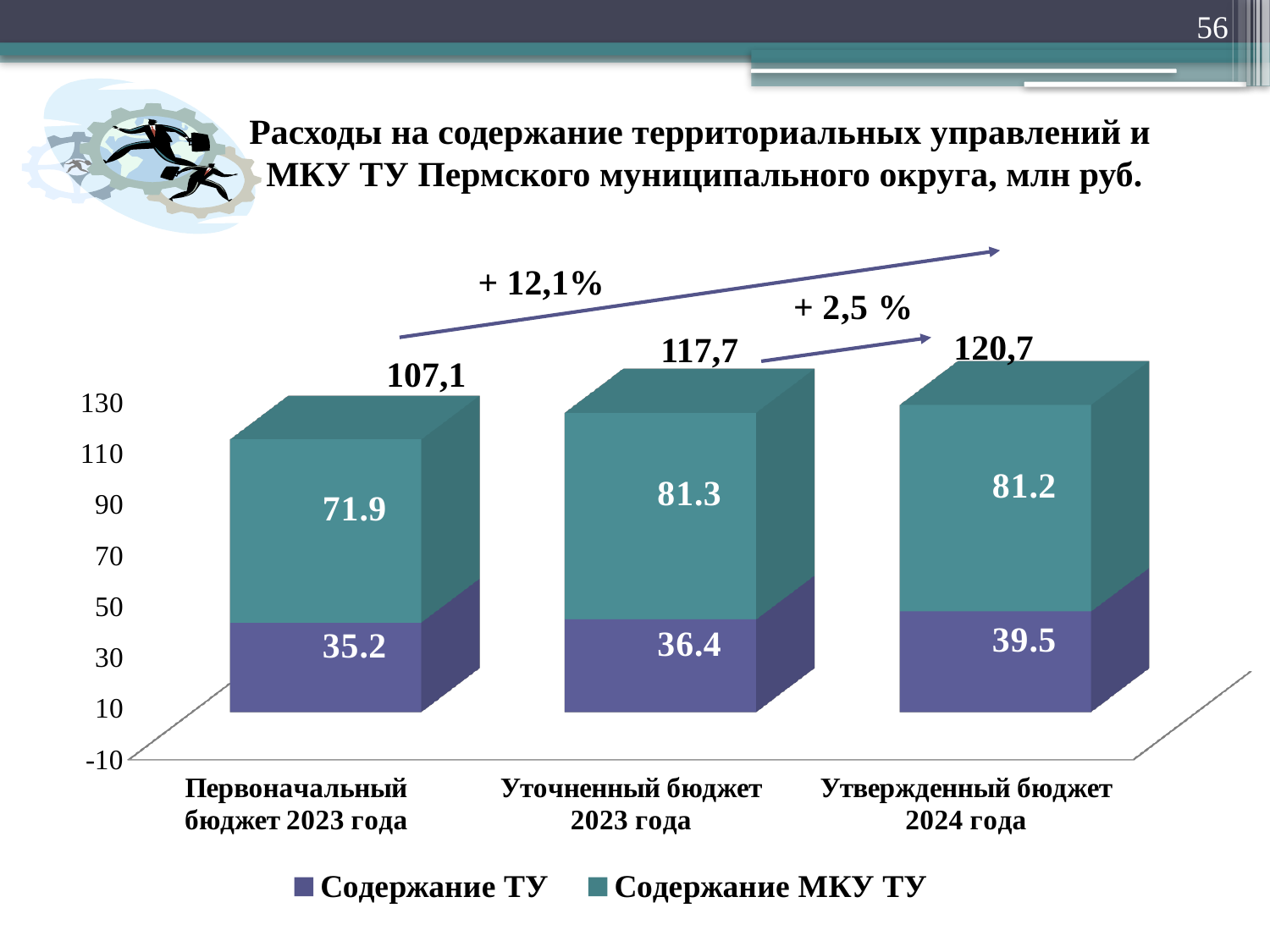
What is the value for Содержание ТУ in the Утвержденный бюджет 2024 года category? 39.5 How many series does the legend list? 2 What is the total shown above the bar for Утвержденный бюджет 2024 года? 120,7 What is the value for Содержание ТУ in the Первоначальный бюджет 2023 года category? 35.2 How many categories are shown on the x axis? 3 What kind of chart is shown on the slide? Stacked bar chart Which is larger: Содержание МКУ ТУ for Уточненный бюджет 2023 года or for Первоначальный бюджет 2023 года? Уточненный бюджет 2023 года What is the value for Содержание МКУ ТУ in the Уточненный бюджет 2023 года category? 81.3 What is the difference between the Содержание ТУ values for Утвержденный бюджет 2024 года and Первоначальный бюджет 2023 года? 4.3 What is the total shown above the bar for Первоначальный бюджет 2023 года? 107,1 Which category has the lowest value for Содержание МКУ ТУ? Первоначальный бюджет 2023 года Which category has the highest value for Содержание ТУ? Утвержденный бюджет 2024 года